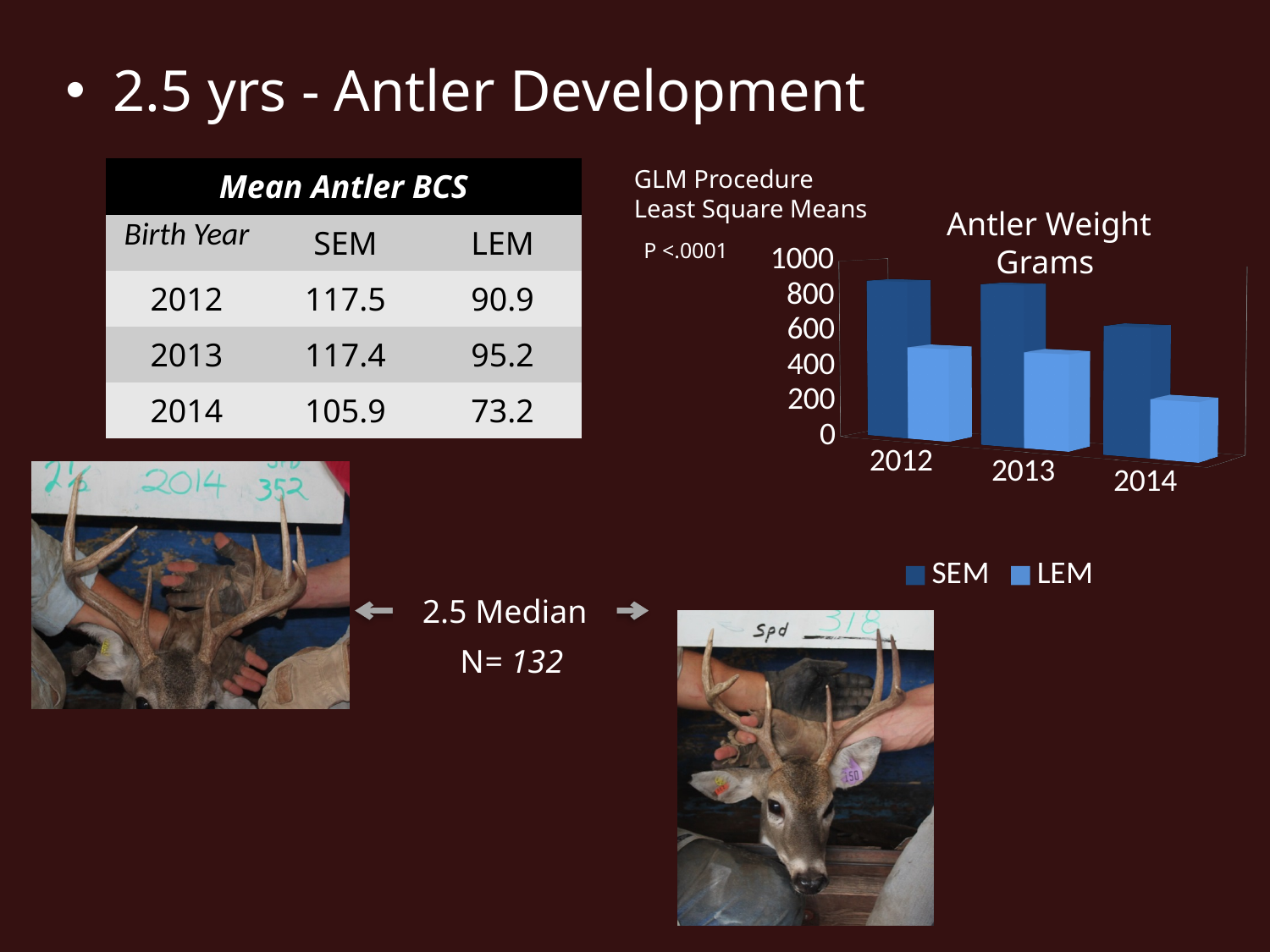
In the Antler Weight Grams chart, which year has the lowest LEM value? 2014 How many series does the legend of the Antler Weight Grams chart list? 2 In the Antler Weight Grams chart, is the SEM value for 2012 greater or less than 600? greater In the Antler Weight Grams chart, is the SEM value for 2014 greater or less than 400? greater In the Antler Weight Grams chart, is the LEM value for 2014 greater or less than 400? less What kind of chart is the Antler Weight Grams chart? bar chart What is the title of the bar chart on the slide? Antler Weight Grams In the Antler Weight Grams chart, which is larger for 2012, SEM or LEM? SEM In the Antler Weight Grams chart, do the LEM values rise or fall from 2012 to 2014? fall In the Antler Weight Grams chart, which year has the lowest SEM value? 2014 What are the two series named in the legend of the Antler Weight Grams chart? SEM and LEM How many birth years are shown on the x axis of the Antler Weight Grams chart? 3